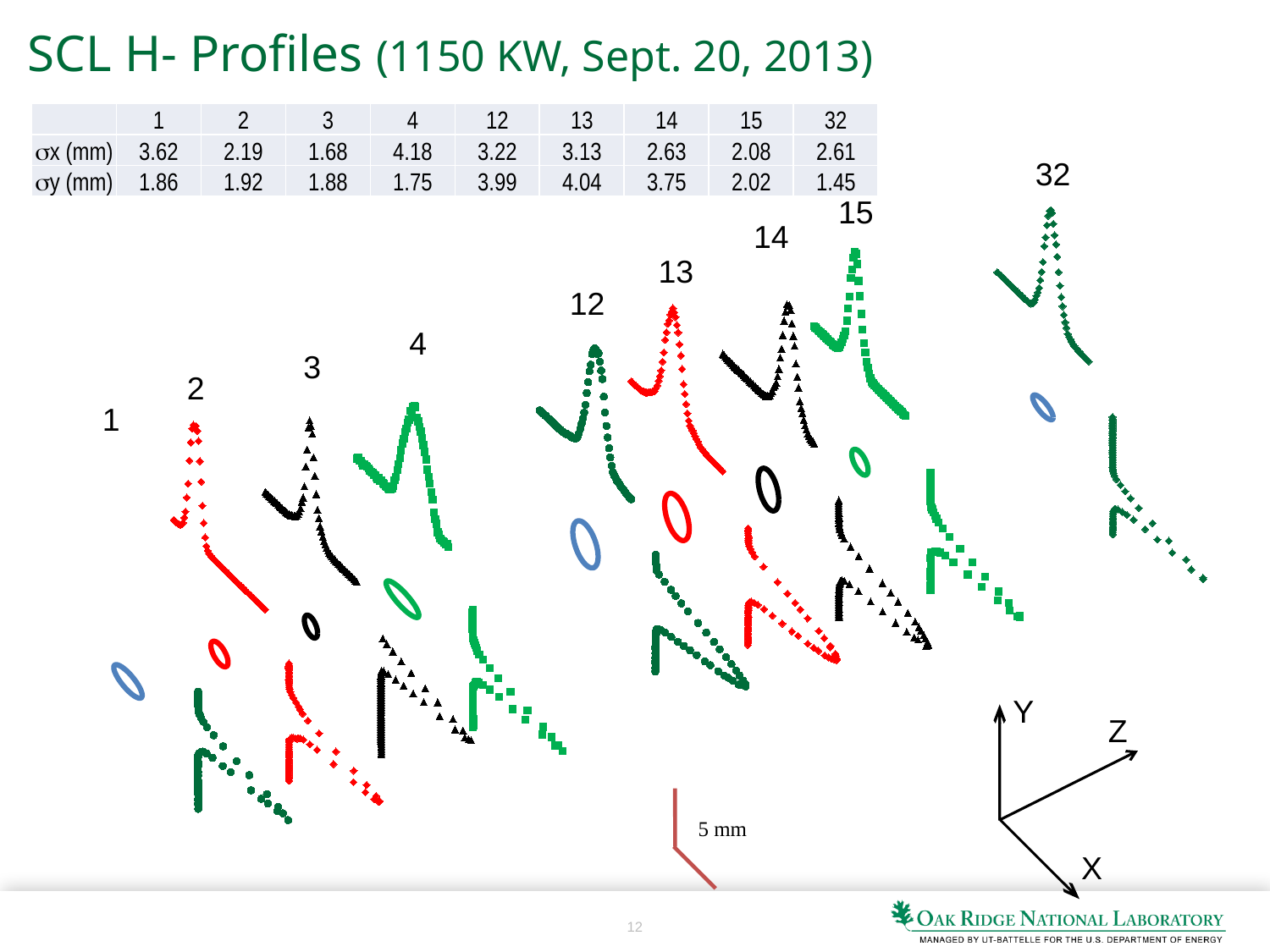
What length does the scale bar on the profile plot represent? 5 mm Which profile has the smallest σx value? 3 How many profiles are listed in the table? 9 What is the σx value (mm) for profile 32? 2.61 What is the difference between the σx values of profile 4 and profile 3? 2.50 What is the σy value (mm) for profile 13? 4.04 What is the difference between the σy values of profile 13 and profile 32? 2.59 What kind of chart is used to show the beam profiles? scatter plot Which profile has the smallest σy value? 32 What is the σx value (mm) for profile 4? 4.18 Which is larger, the σx value for profile 1 or the σx value for profile 2? profile 1 Which profile has the largest σx value? 4